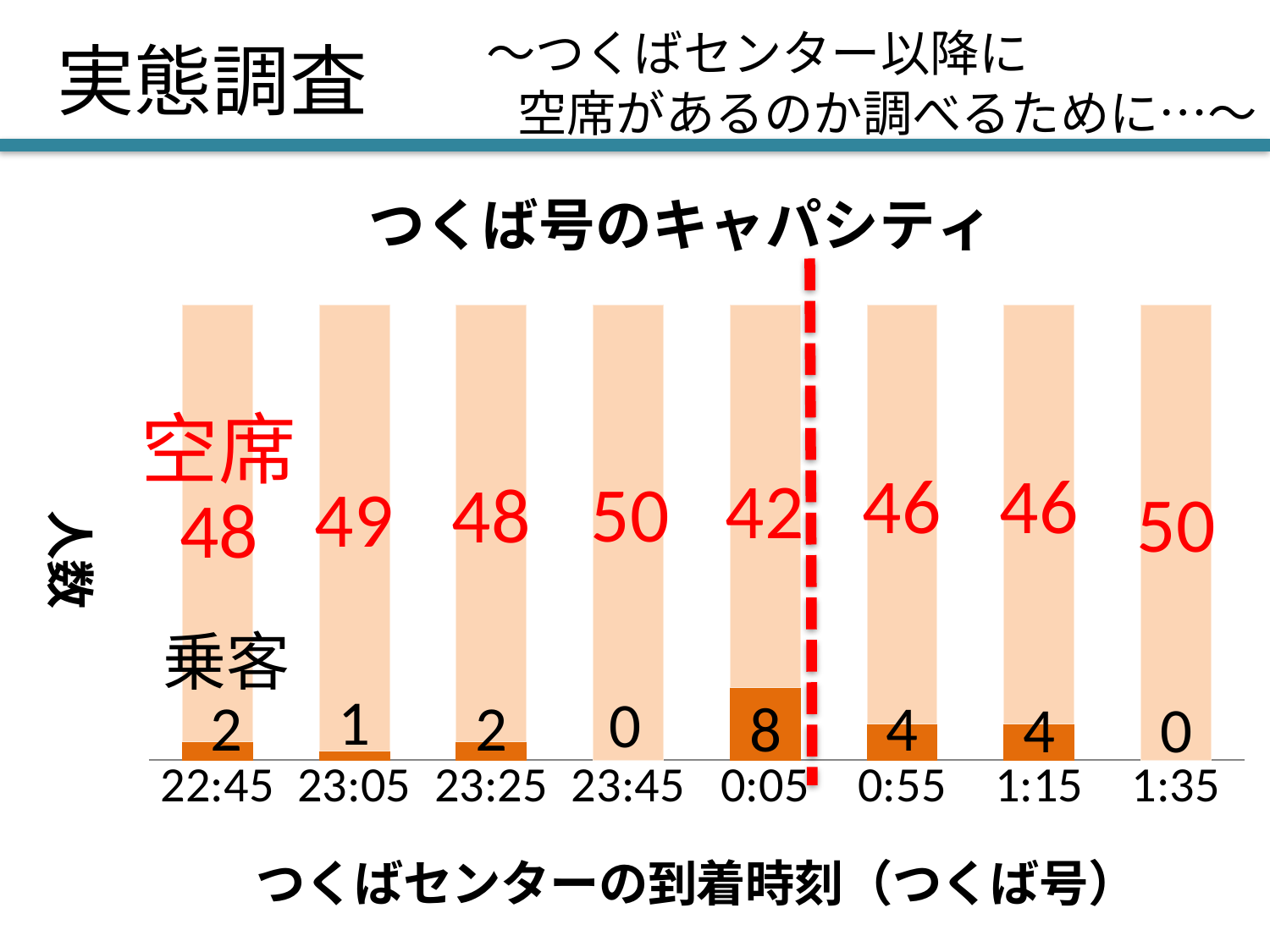
What is the label of the x axis? つくばセンターの到着時刻（つくば号） How many series are shown in the chart? 2 Which arrival time has the highest number of 乗客 (passengers)? 0:05 What is the title of the chart? つくば号のキャパシティ Which arrival time has the lowest number of 空席 (empty seats)? 0:05 What kind of chart is shown on the slide? Stacked bar chart What is the number of 乗客 (passengers) for the 0:05 arrival? 8 What is the total of 空席 and 乗客 for the 1:15 arrival? 50 What is the number of 空席 (empty seats) for the 23:05 arrival? 49 Which has more 乗客 (passengers): the 0:55 arrival or the 23:25 arrival? 0:55 How many arrival times are shown on the x axis? 8 What is the difference between the 空席 value at 23:45 and the 空席 value at 0:05? 8